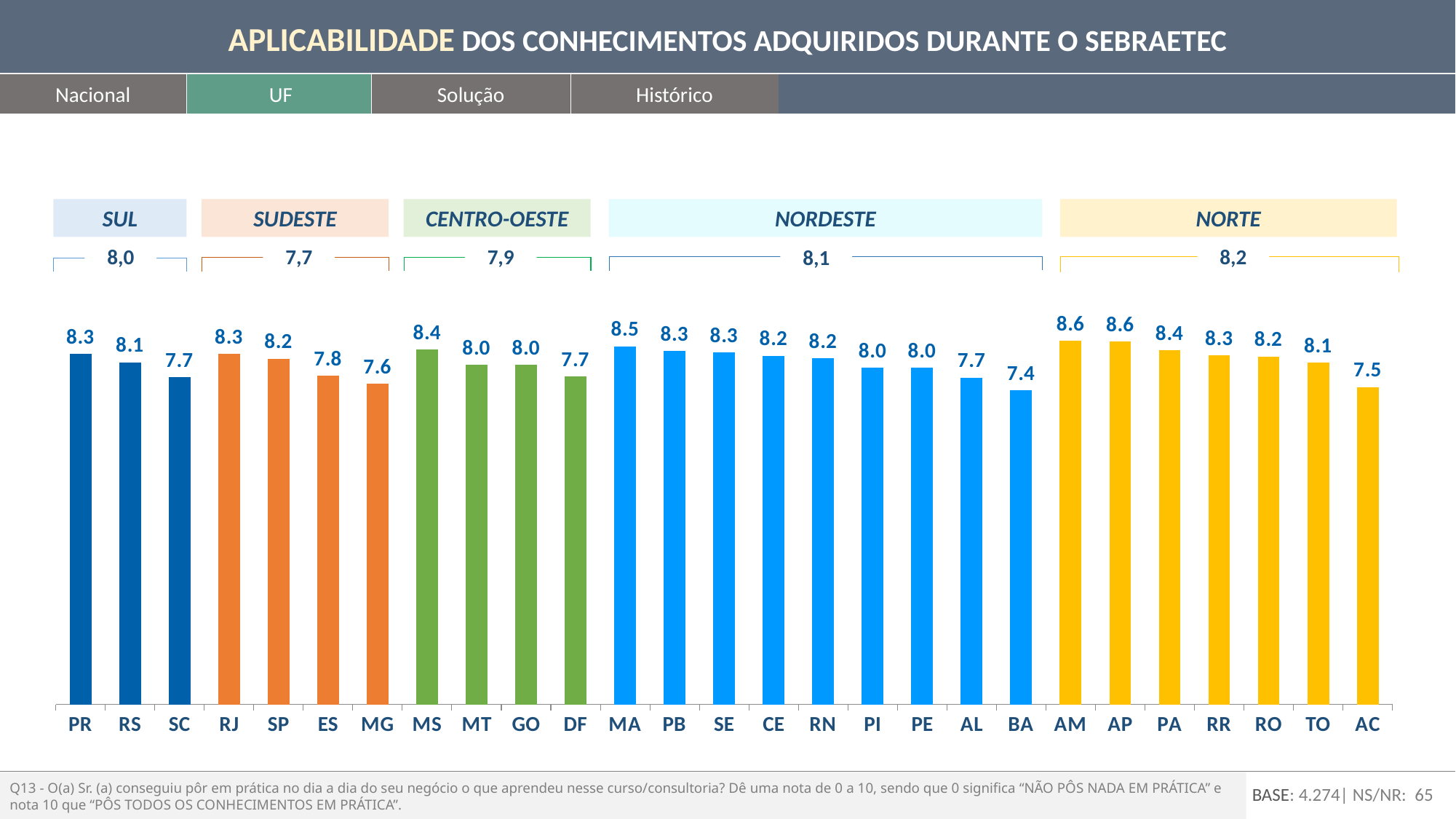
What is the highest value shown among the states? 8.6 What kind of chart is shown? bar chart How many states are in the NORDESTE group? 9 What is the difference between the values for AM and AC? 1.1 What is the value for BA? 7.4 Which has a larger value, PR or SC? PR What is the average value shown for the NORTE region? 8,2 What is the value for MA? 8.5 Which region has the lowest average value shown above the chart? SUDESTE Which state has the lowest value? BA How many states are shown on the chart? 27 What is the value for MG? 7.6